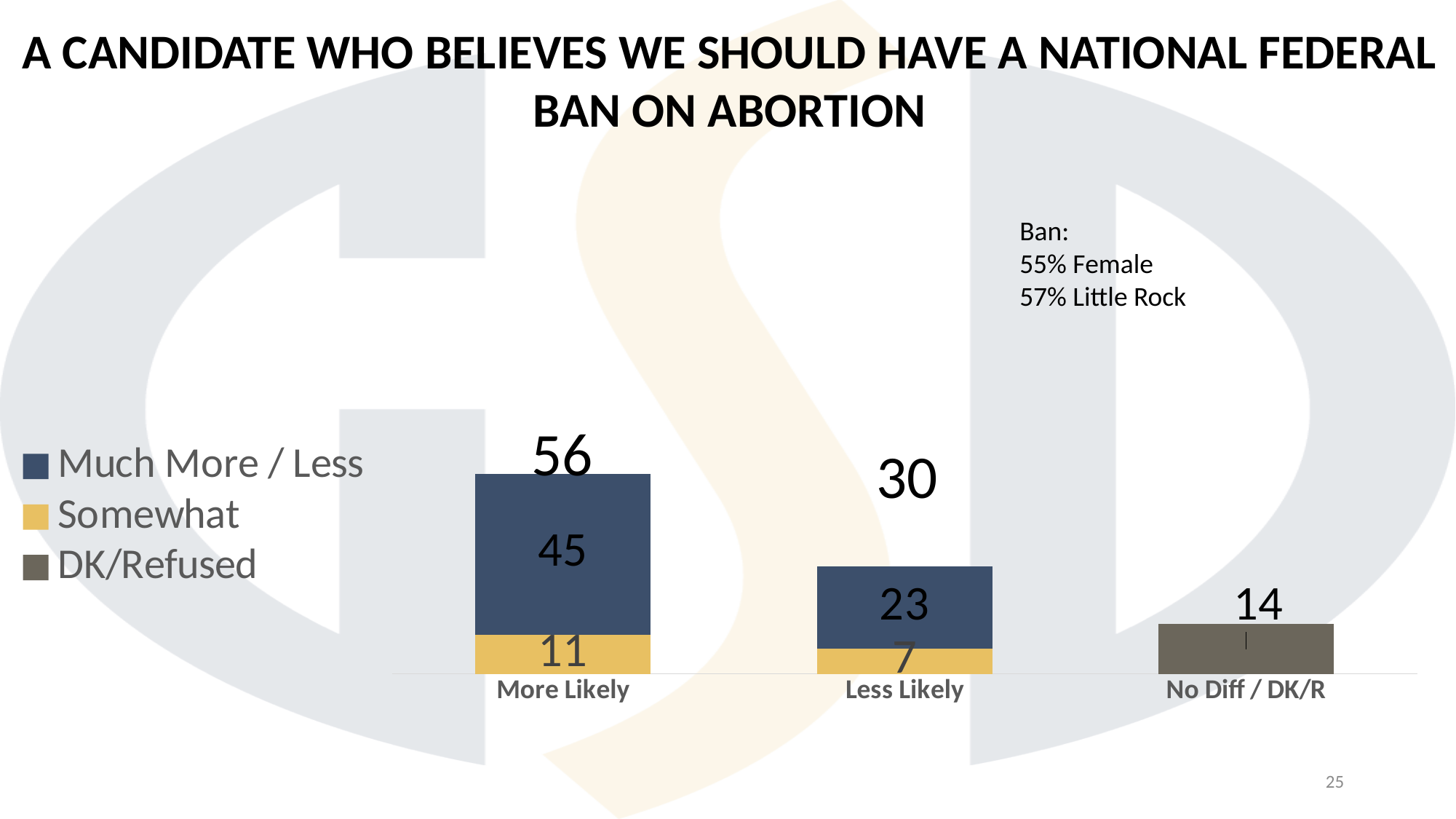
How many categories are shown on the x axis? 3 How many series does the legend list? 3 Which category has the lowest total? No Diff / DK/R What is the value shown for No Diff / DK/R? 14 What is the difference between the Much More / Less values for More Likely and Less Likely? 22 What is the total of the stacked bar for Less Likely? 30 What is the total of the stacked bar for More Likely? 56 Which is larger: the Somewhat value for More Likely or the Somewhat value for Less Likely? More Likely What kind of chart is shown on the slide? Stacked bar chart What is the value of the Somewhat segment for Less Likely? 7 Which category has the highest total? More Likely What is the value of the Much More / Less segment for More Likely? 45